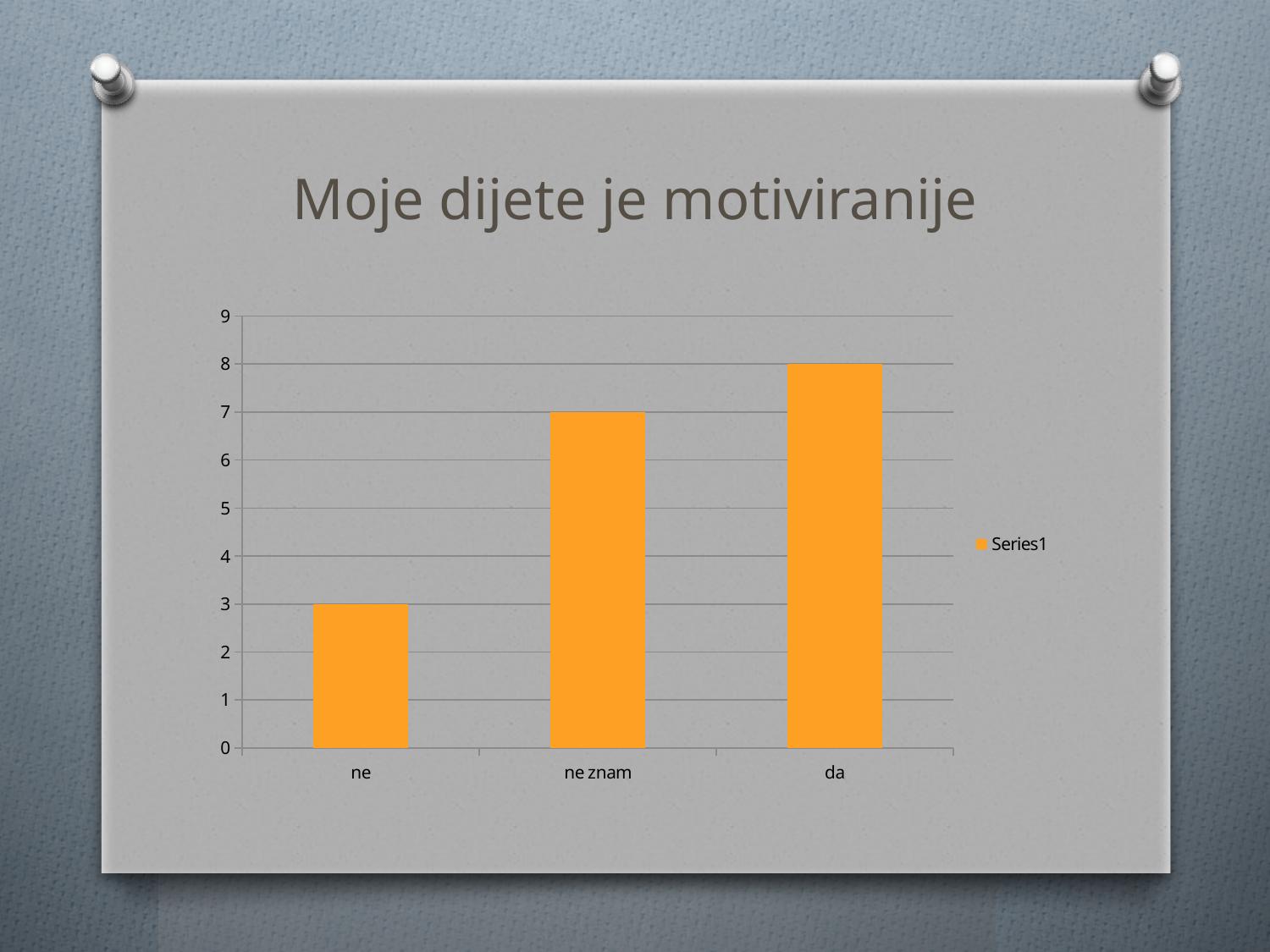
How many categories are shown on the x axis? 3 What is the value for "ne znam"? 7 What is the value for "da"? 8 How many series does the legend list? 1 Which category has the lowest value? ne What is the difference between the values for "da" and "ne"? 5 Which is larger, the value for "ne znam" or the value for "ne"? ne znam What kind of chart is shown on the slide? bar chart Which category has the highest value? da What is the value for "ne"? 3 Is the value for "ne" greater or less than 5? less What is the title of the slide? Moje dijete je motiviranije